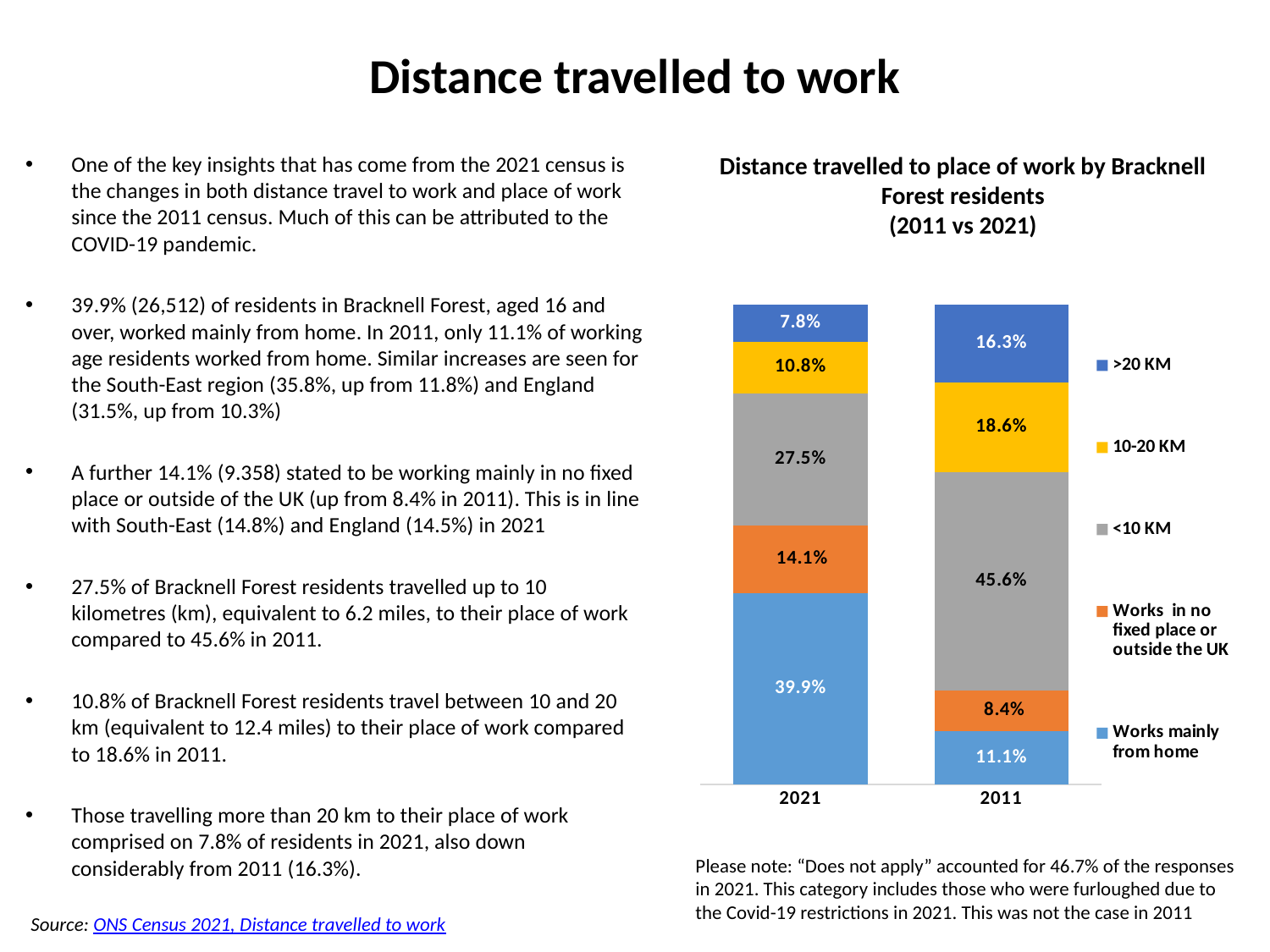
How many series does the chart legend list? 5 Which is larger: 'Works mainly from home' in 2021 or '<10 KM' in 2021? Works mainly from home in 2021 Which segment is the smallest in the 2021 bar? >20 KM What is the value for '>20 KM' in 2021? 7.8% What is the value for 'Works in no fixed place or outside the UK' in 2011? 8.4% What is the difference between the '10-20 KM' values for 2011 and 2021? 7.8% How many categories (years) are shown on the x axis of the chart? 2 What is the value for 'Works mainly from home' in 2021? 39.9% Which segment is the largest in the 2011 bar? <10 KM What is the value for '<10 KM' in 2011? 45.6% What kind of chart is shown on the slide? Stacked bar chart What is the title of the chart? Distance travelled to place of work by Bracknell Forest residents (2011 vs 2021)